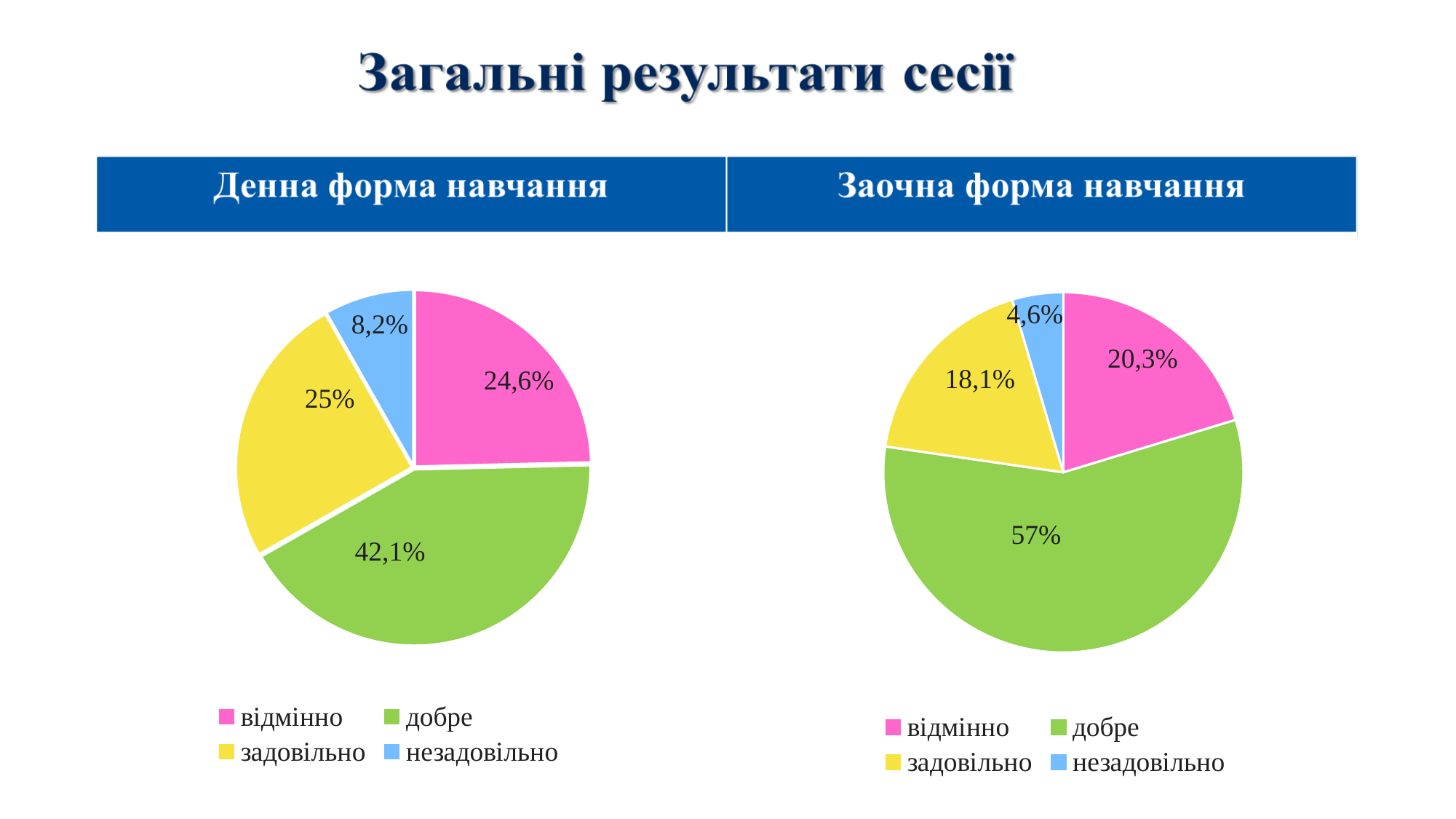
In the 'Денна форма навчання' pie chart, what is the value for 'добре'? 42,1% Which chart has the larger share for 'незадовільно', 'Денна форма навчання' or 'Заочна форма навчання'? Денна форма навчання What type of chart is used under 'Заочна форма навчання'? Pie chart How many slices does the 'Денна форма навчання' pie chart have? 4 In the 'Заочна форма навчання' pie chart, what is the value for 'незадовільно'? 4,6% In the 'Денна форма навчання' pie chart, what is the value for 'відмінно'? 24,6% In the 'Заочна форма навчання' pie chart, what colour is the 'добре' slice? Green In the 'Заочна форма навчання' pie chart, what is the difference between 'відмінно' and 'задовільно'? 2,2% In the 'Денна форма навчання' pie chart, what is the difference between 'добре' and 'відмінно'? 17,5% In the 'Денна форма навчання' pie chart, which category has the smallest share? незадовільно In the 'Заочна форма навчання' pie chart, which category has the largest share? добре In the 'Заочна форма навчання' pie chart, what is the value for 'задовільно'? 18,1%